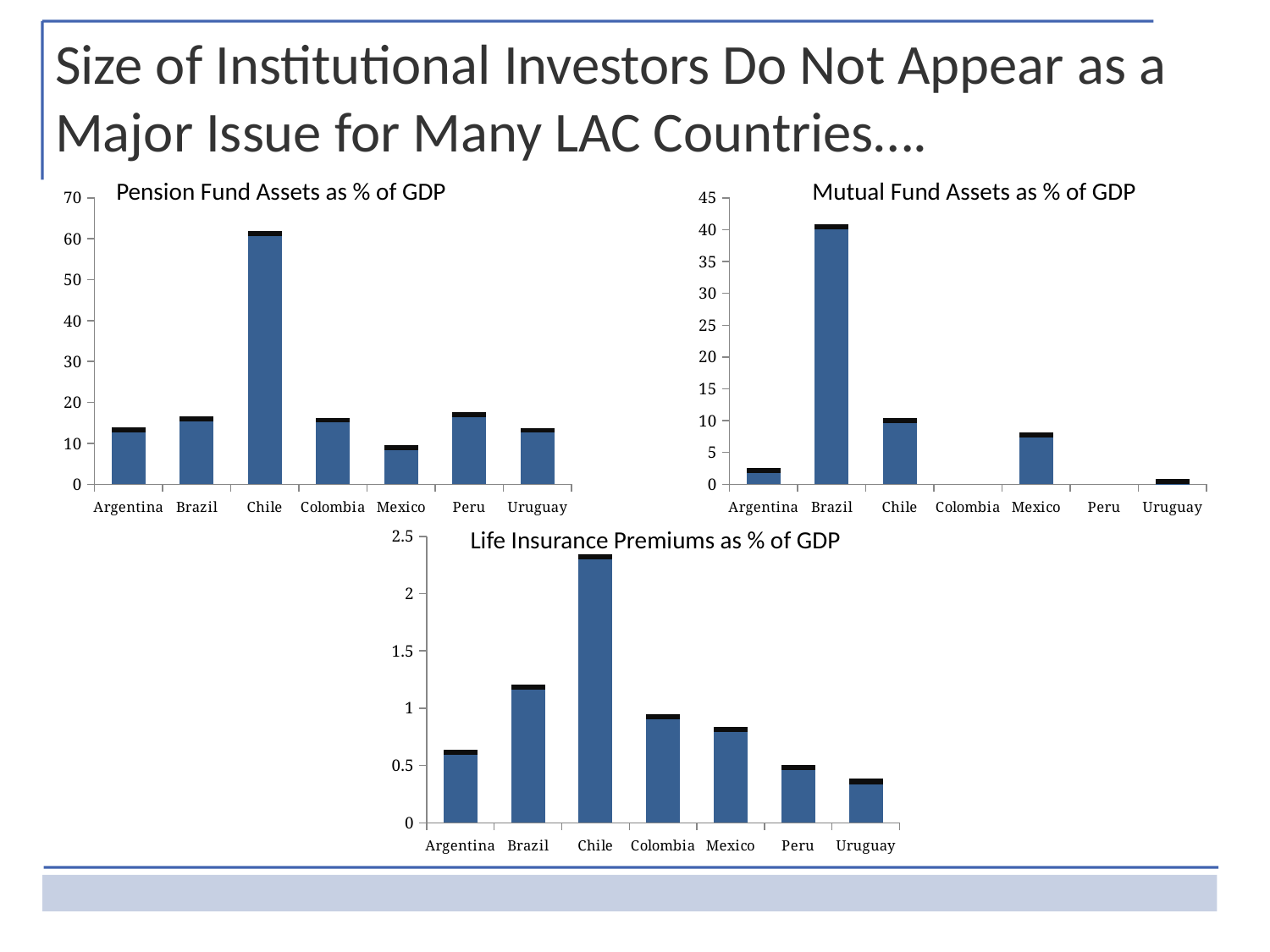
In the Pension Fund Assets as % of GDP chart, is the value for Chile greater or less than 60? greater What type of chart is the Life Insurance Premiums as % of GDP chart? Bar chart How many countries are shown in the Pension Fund Assets as % of GDP chart? 7 In the Pension Fund Assets as % of GDP chart, which country has the highest value? Chile In the Mutual Fund Assets as % of GDP chart, is the value for Brazil greater or less than 40? greater In the Mutual Fund Assets as % of GDP chart, which country has the highest value? Brazil In the Life Insurance Premiums as % of GDP chart, which country has the highest value? Chile In the Life Insurance Premiums as % of GDP chart, is the value for Brazil greater or less than 1? greater In the Pension Fund Assets as % of GDP chart, which country has the lowest value? Mexico In the Mutual Fund Assets as % of GDP chart, is the value for Chile larger than the value for Mexico? Yes In the Life Insurance Premiums as % of GDP chart, which is larger, Colombia or Mexico? Colombia